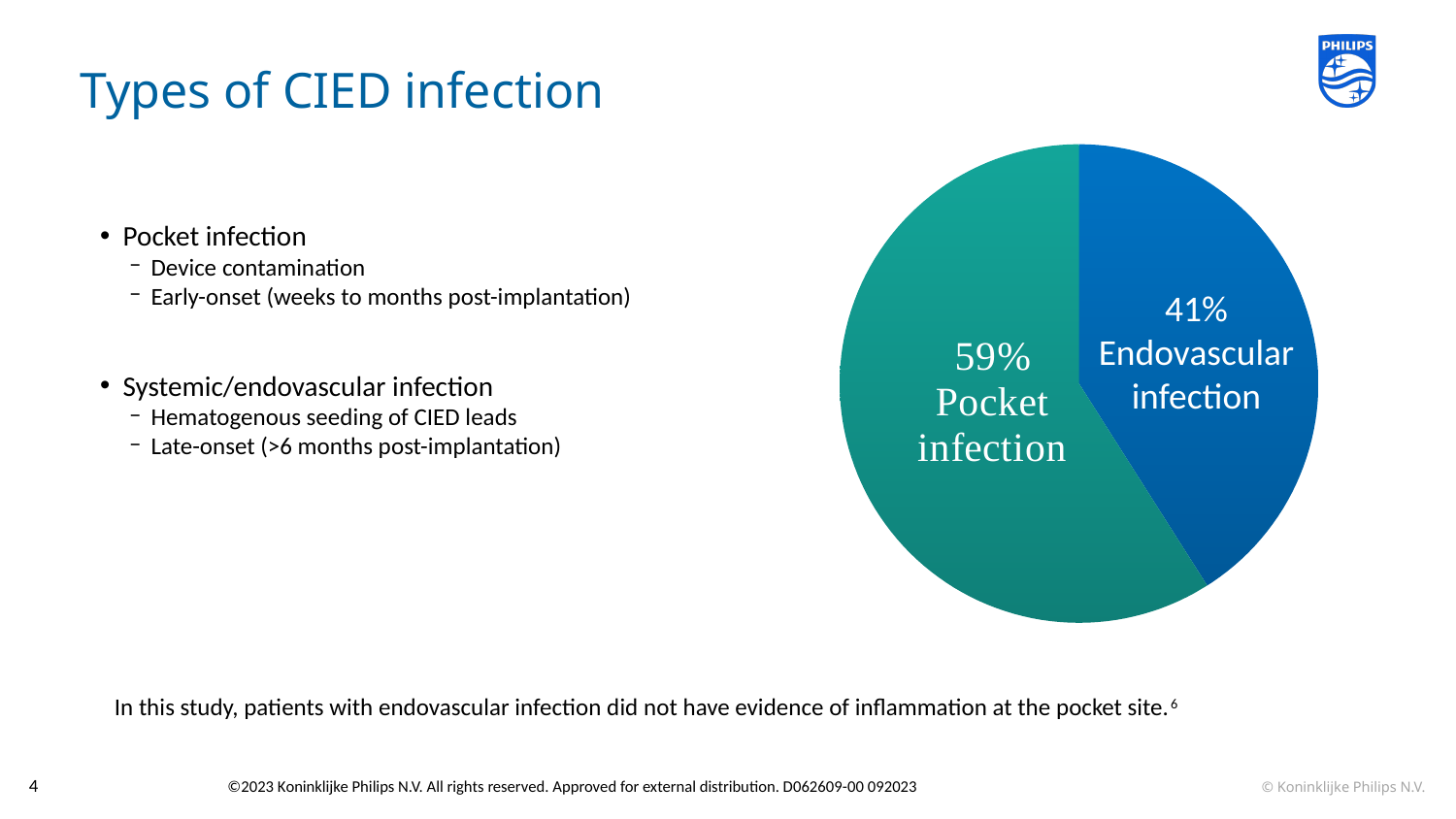
What is the title of the slide containing the pie chart? Types of CIED infection Which is larger, the Pocket infection slice or the Endovascular infection slice? Pocket infection Is the share for Pocket infection greater or less than 50%? greater Which slice of the pie is the largest? Pocket infection What is the difference in percentage points between the Pocket infection and Endovascular infection slices? 18 What colour is the Endovascular infection slice? blue What share of the pie is Endovascular infection? 41% What kind of chart is shown on the slide? pie chart What share of the pie is Pocket infection? 59% Is the share for Endovascular infection greater or less than 50%? less Which slice of the pie is the smallest? Endovascular infection How many slices does the pie chart have? 2